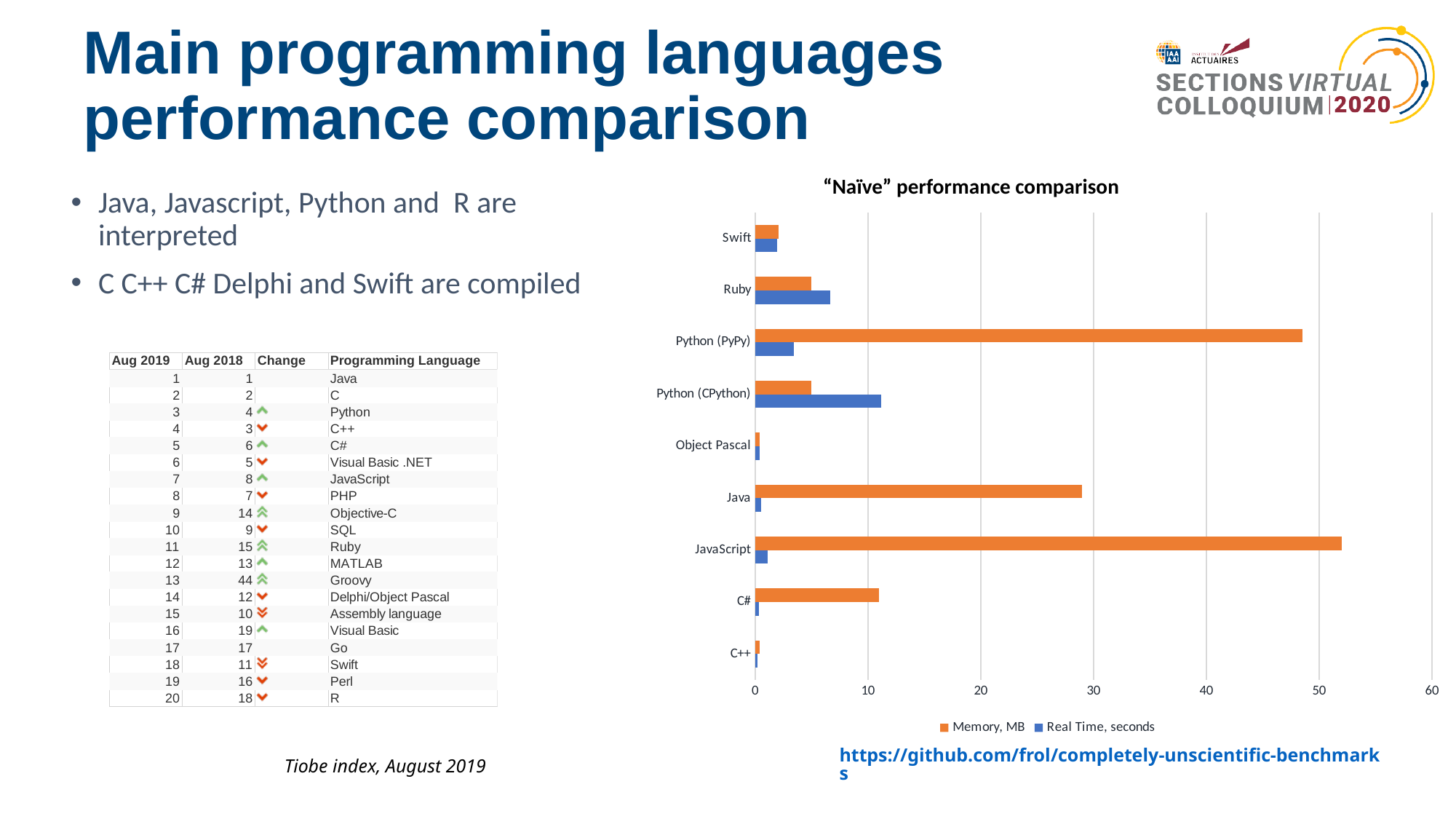
What kind of chart is the "Naïve" performance comparison chart? bar chart How many series does the legend of the "Naïve" performance comparison chart list? 2 Is the Memory, MB value for JavaScript greater or less than 50? greater Which has the larger Memory, MB value: Java or C#? Java Is the Real Time, seconds value for Ruby greater or less than 10? less Is the Memory, MB value for Java greater or less than 30? less Which language has the highest Real Time, seconds value in the "Naïve" performance comparison chart? Python (CPython) Which language has the highest Memory, MB value in the "Naïve" performance comparison chart? JavaScript Which has the larger Real Time, seconds value: Python (CPython) or Python (PyPy)? Python (CPython) How many programming languages are plotted in the "Naïve" performance comparison chart? 9 Which series is shown in orange in the "Naïve" performance comparison chart? Memory, MB